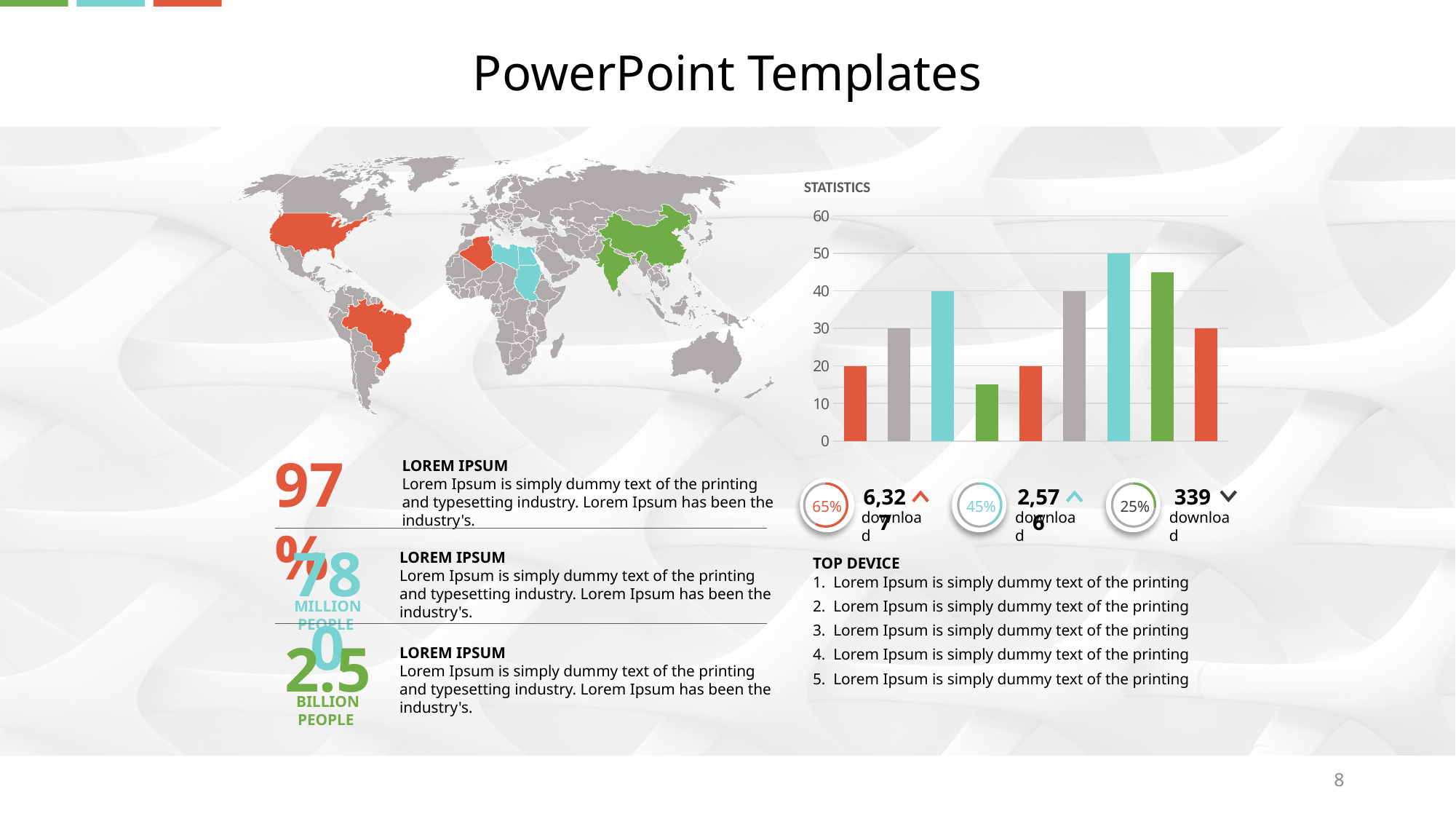
In the STATISTICS chart, what value does the first bar from the left reach? 20 In the STATISTICS chart, which bar is the tallest? the seventh bar from the left What kind of chart is the STATISTICS chart? bar chart In the STATISTICS chart, what value does the seventh bar from the left reach? 50 How many bars are plotted in the STATISTICS chart? 9 In the STATISTICS chart, is the value of the fourth bar from the left greater or less than 20? less In the STATISTICS chart, which bar is the shortest? the fourth bar from the left In the STATISTICS chart, what value does the second bar from the left reach? 30 In the STATISTICS chart, is the value of the eighth bar from the left greater or less than 40? greater In the STATISTICS chart, what is the difference between the seventh bar (50) and the first bar (20)? 30 In the STATISTICS chart, what value does the third bar from the left reach? 40 What is the title shown above the bar chart? STATISTICS